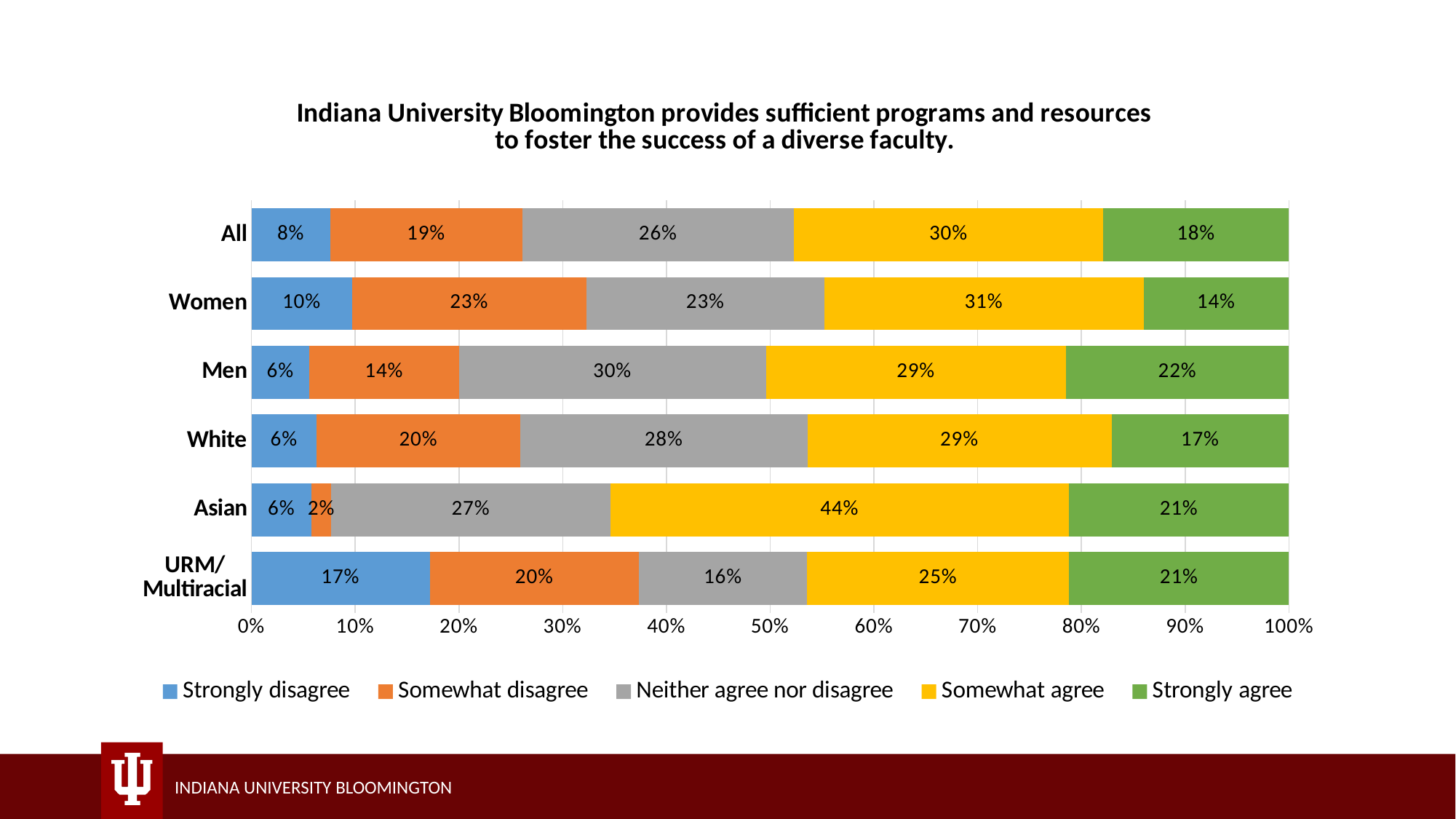
How many response categories does the legend list? 5 Which group has the highest percentage of 'Somewhat agree' responses? Asian What percentage of URM/Multiracial faculty strongly disagree? 17% What percentage of Women neither agree nor disagree? 23% What percentage of Asian faculty somewhat agree that Indiana University Bloomington provides sufficient programs and resources to foster the success of a diverse faculty? 44% How many groups (categories) are shown on the chart? 6 Which colour represents 'Neither agree nor disagree' in the chart? Gray What kind of chart is shown on the slide? Stacked bar chart Which group has a larger 'Strongly disagree' percentage, Women or Men? Women What is the combined percentage of 'Somewhat agree' and 'Strongly agree' for the All group? 48% Which group has the lowest percentage of 'Somewhat disagree' responses? Asian What is the difference between the 'Strongly agree' percentage for Men and for Women? 8%